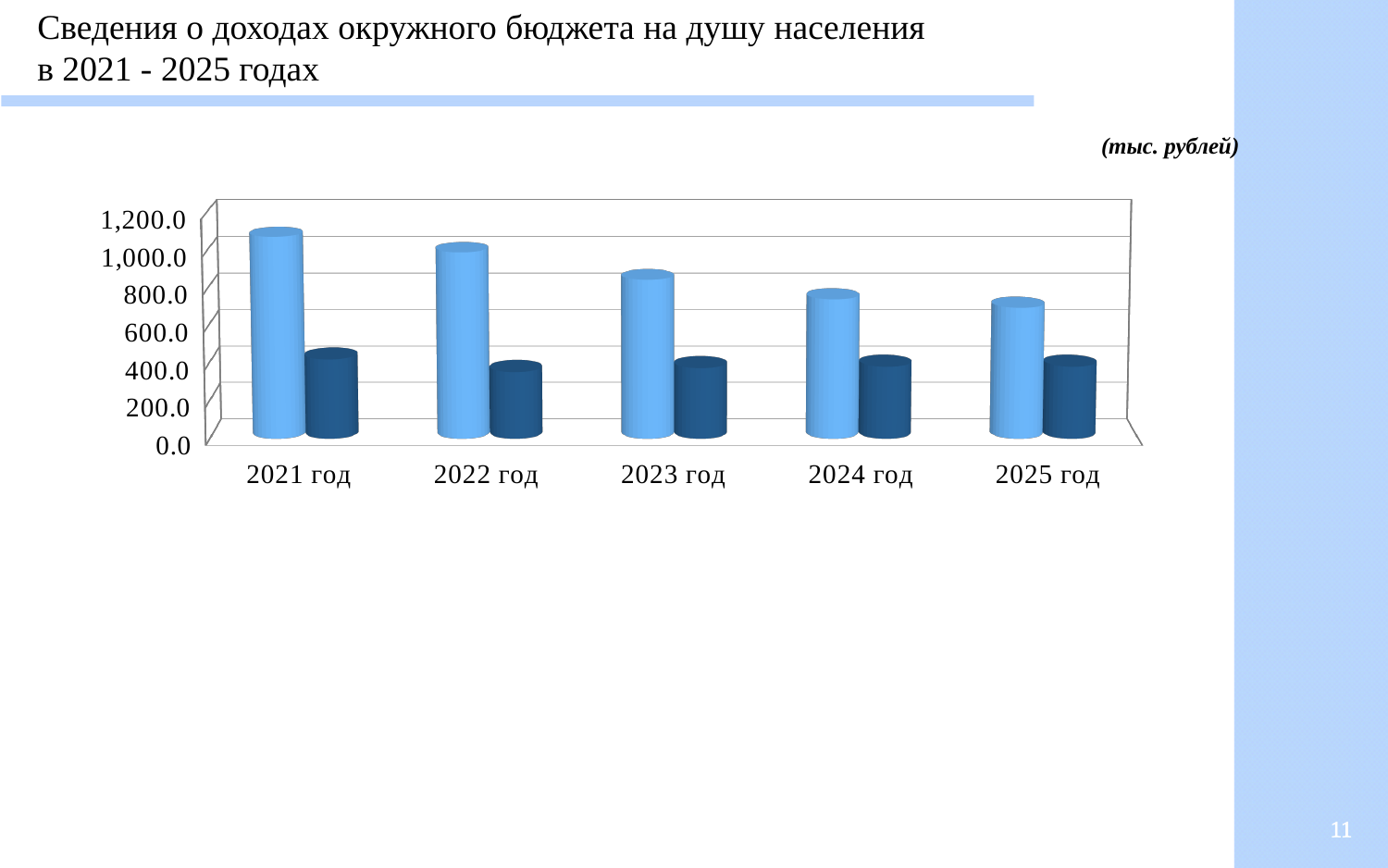
For 2022 год, which bar is larger, the light blue one or the dark blue one? the light blue one What kind of chart is shown on the slide? bar chart Do the light blue bars rise or fall from 2021 год to 2025 год? fall Is the light blue bar for 2024 год greater or less than 600.0? greater What is the title of the slide containing the chart? Сведения о доходах окружного бюджета на душу населения в 2021 - 2025 годах What unit of measurement is indicated for the chart values? тыс. рублей How many years (categories) are shown on the x axis of the chart? 5 Is the dark blue bar for 2021 год greater or less than 600.0? less Is the light blue bar for 2021 год greater or less than 800.0? greater Which year has the highest light blue bar? 2021 год Which year has the lowest light blue bar? 2025 год